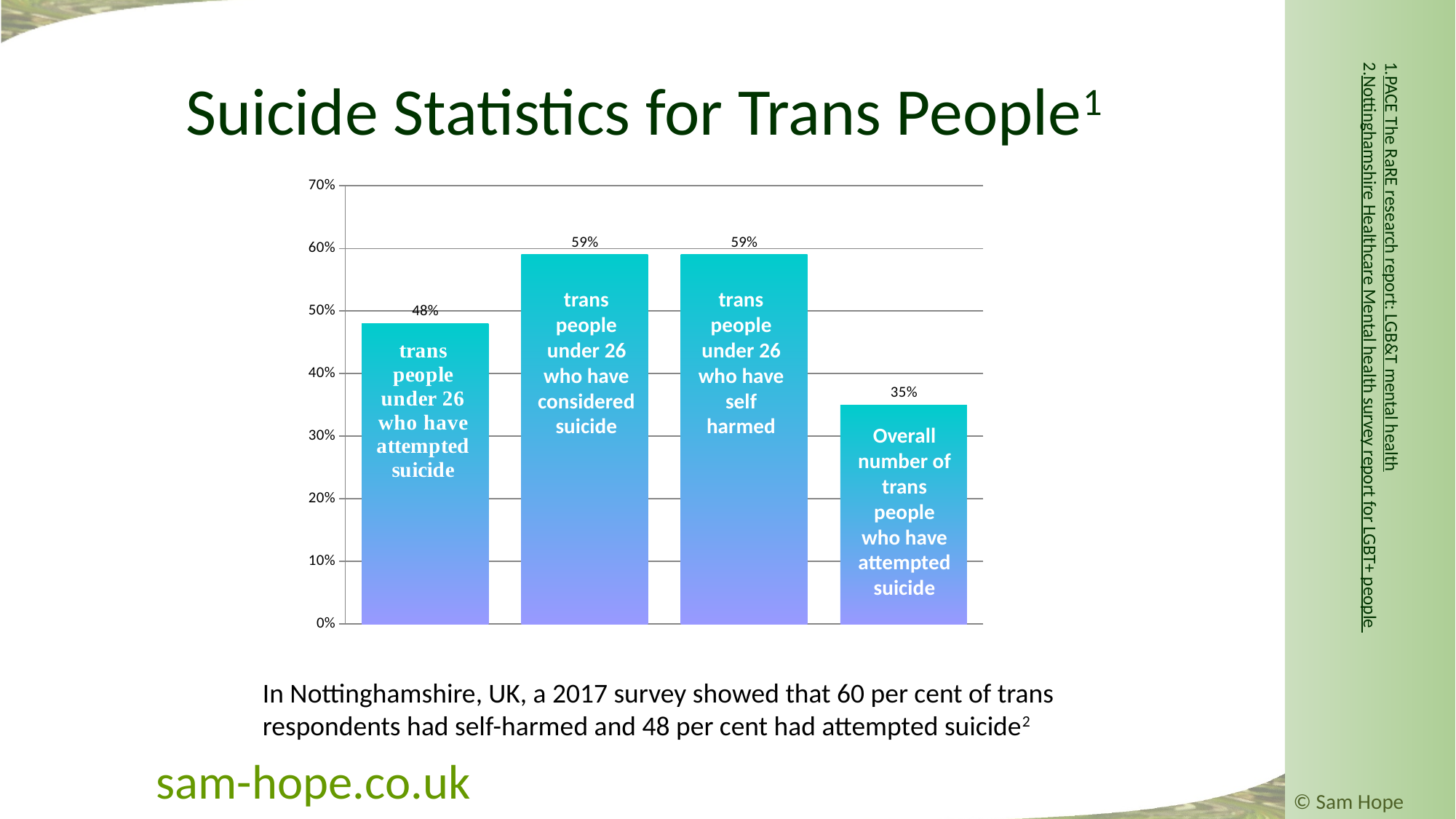
What is the value for trans people under 26 who have attempted suicide? 48% What is the difference between the value for trans people under 26 who have attempted suicide and the overall number of trans people who have attempted suicide? 13% Which is larger: the value for trans people under 26 who have attempted suicide or the overall number of trans people who have attempted suicide? trans people under 26 who have attempted suicide What is the title of the slide containing the chart? Suicide Statistics for Trans People What is the value for trans people under 26 who have considered suicide? 59% What kind of chart is shown on the slide? bar chart How many bars are shown in the chart? 4 What is the value for trans people under 26 who have self harmed? 59% Which category has the lowest value? Overall number of trans people who have attempted suicide Is the value for trans people under 26 who have self harmed greater or less than 50%? greater What is the difference between the value for trans people under 26 who have considered suicide and the overall number of trans people who have attempted suicide? 24% What is the value for the overall number of trans people who have attempted suicide? 35%